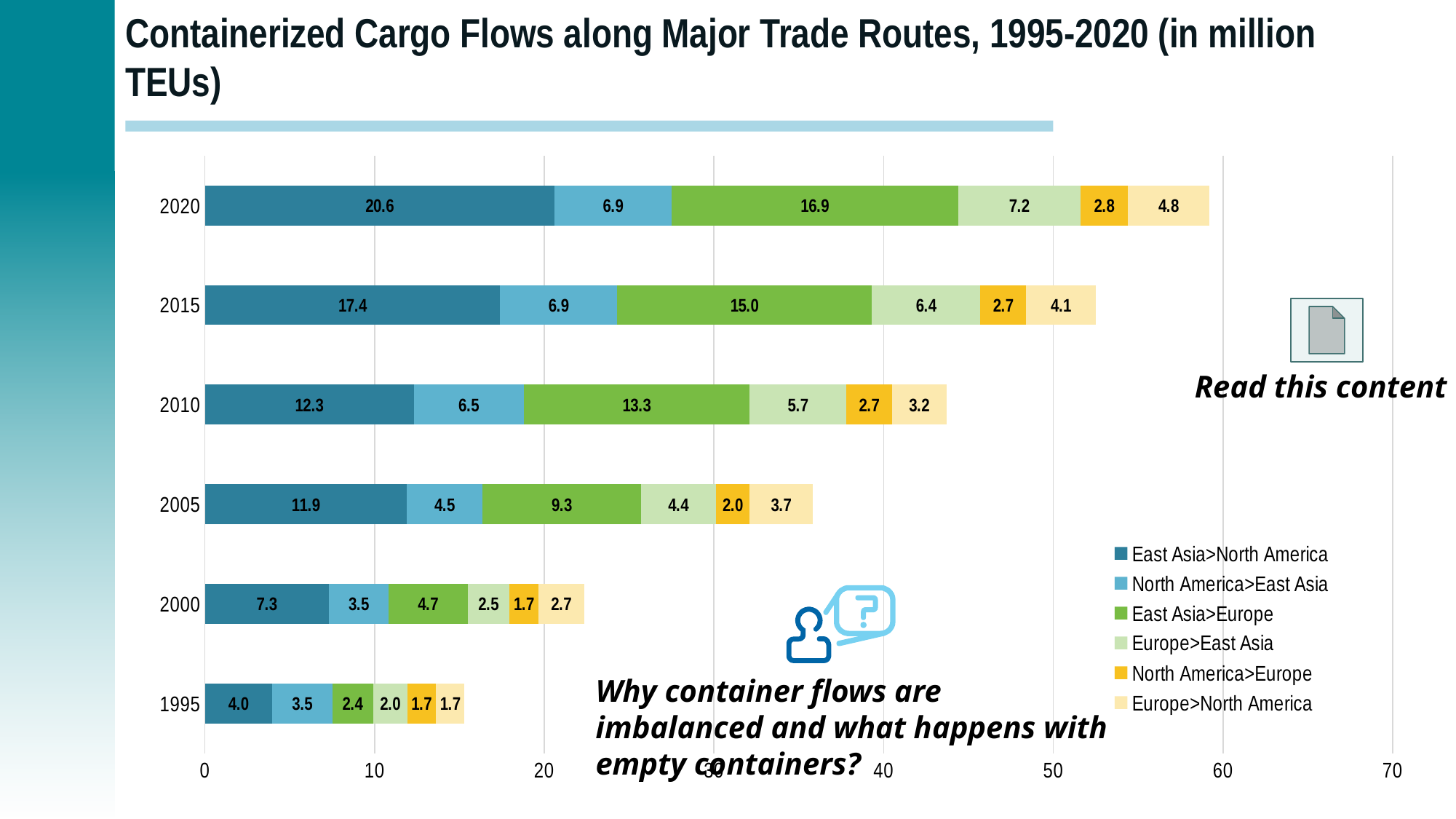
How many years are shown on the chart? 6 What is the value for Europe>North America in 2005? 3.7 Which year has the highest value for East Asia>North America? 2020 Which year has the lowest value for East Asia>Europe? 1995 Which is larger in 2010: East Asia>North America or East Asia>Europe? East Asia>Europe What is the total of the stacked bar for 2000? 22.4 What is the difference between the East Asia>North America values for 2020 and 2015? 3.2 What is the value for East Asia>North America in 2020? 20.6 What kind of chart is shown on the slide? Stacked bar chart What is the value for East Asia>Europe in 2010? 13.3 What is the total of the stacked bar for 1995? 15.3 How many series does the legend list? 6